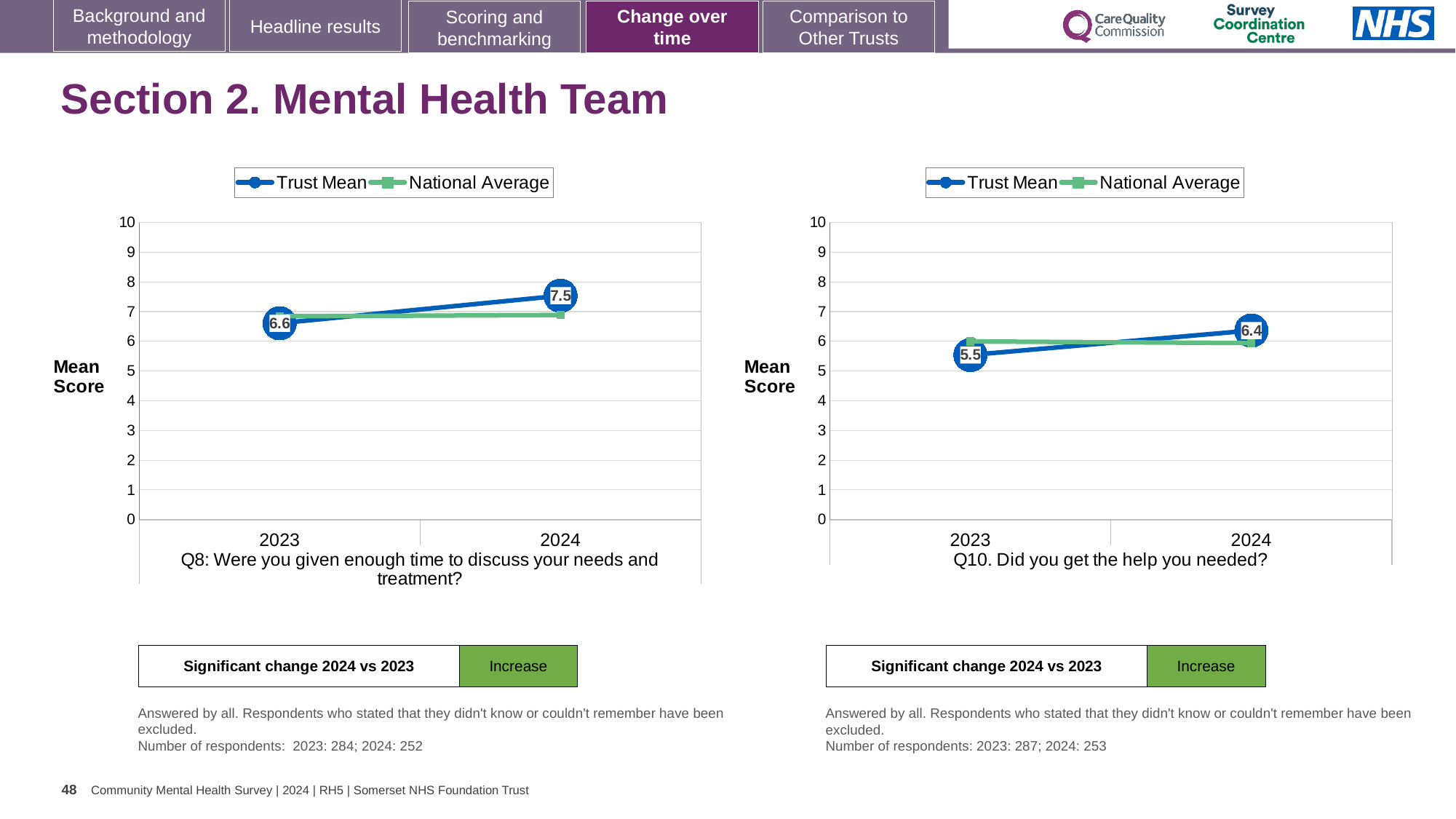
What kind of chart is the Q8 chart? line chart In the Q8 chart, is the Trust Mean for 2024 larger or smaller than the National Average for 2024? larger In the Q8 chart, by how much did the Trust Mean change from 2023 to 2024? 0.9 In the Q8 chart, what is the Trust Mean score for 2024? 7.5 In the Q10 chart, what is the Trust Mean score for 2024? 6.4 In the Q8 chart, is the National Average for 2023 greater or less than 6? greater How many years are shown on the x axis of the Q10 chart? 2 In the Q10 chart, what is the Trust Mean score for 2023? 5.5 In the Q10 chart, does the Trust Mean rise or fall from 2023 to 2024? rise In the Q10 chart, by how much did the Trust Mean change from 2023 to 2024? 0.9 In the Q8 chart, what is the Trust Mean score for 2023? 6.6 How many series does the legend of the Q10 chart list? 2